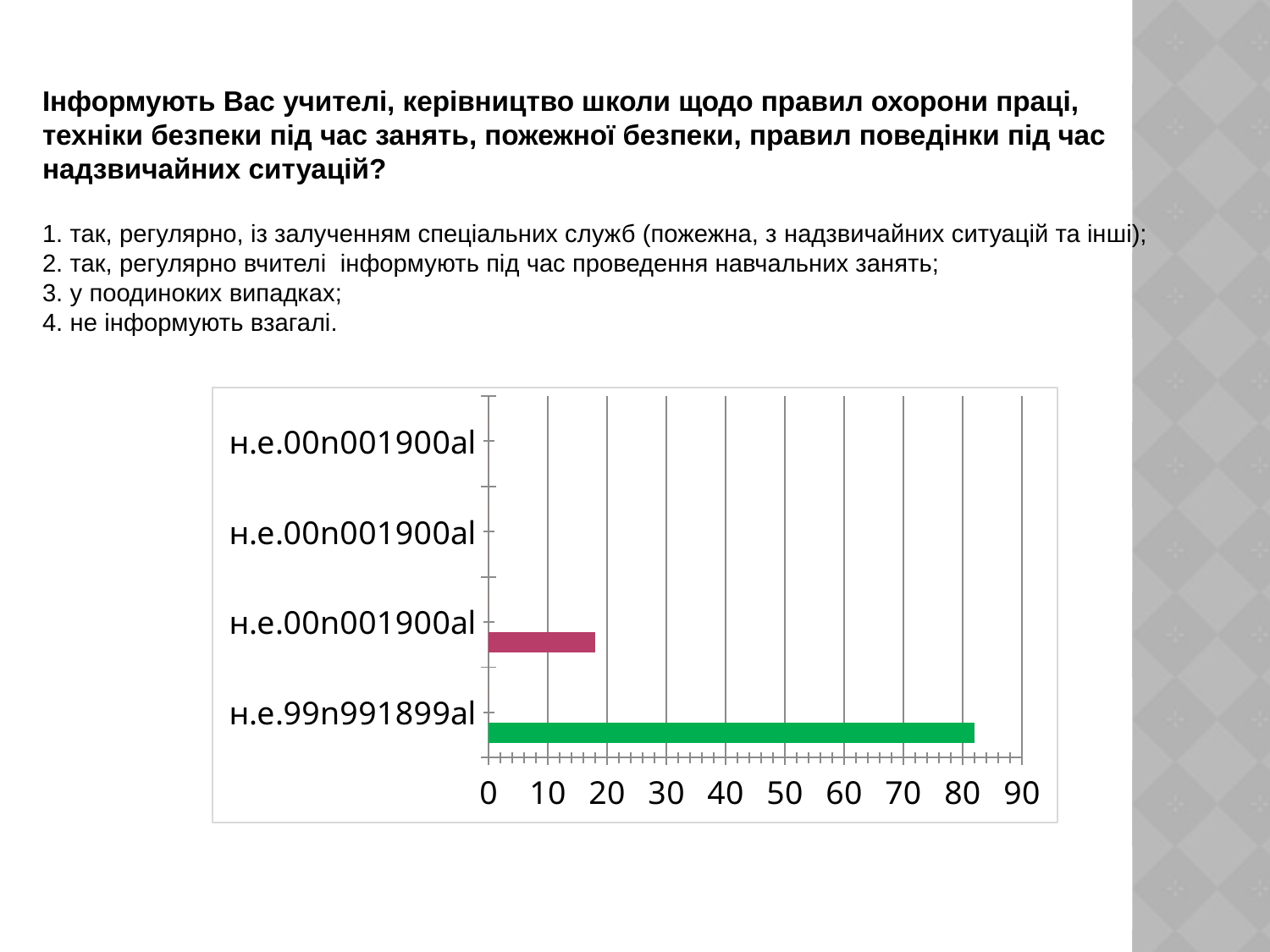
How many categories are shown on the vertical axis of the chart? 4 Which is larger: the value for the bottom category (green bar) or the value for the third category from the top (pink bar)? the bottom category (green bar) Is the value for the bottom category (н.е.99n991899al) greater or less than 70? greater Is the value for the third category from the top (the pink bar) greater or less than 10? greater Is the value for the third category from the top (the pink bar) greater or less than 30? less What kind of chart is shown on the slide? bar chart What is the highest value shown on the horizontal axis of the chart? 90 Which category has the longest bar in the chart? н.е.99n991899al How many categories in the chart have a visible bar? 2 What colour is the longest bar in the chart? green